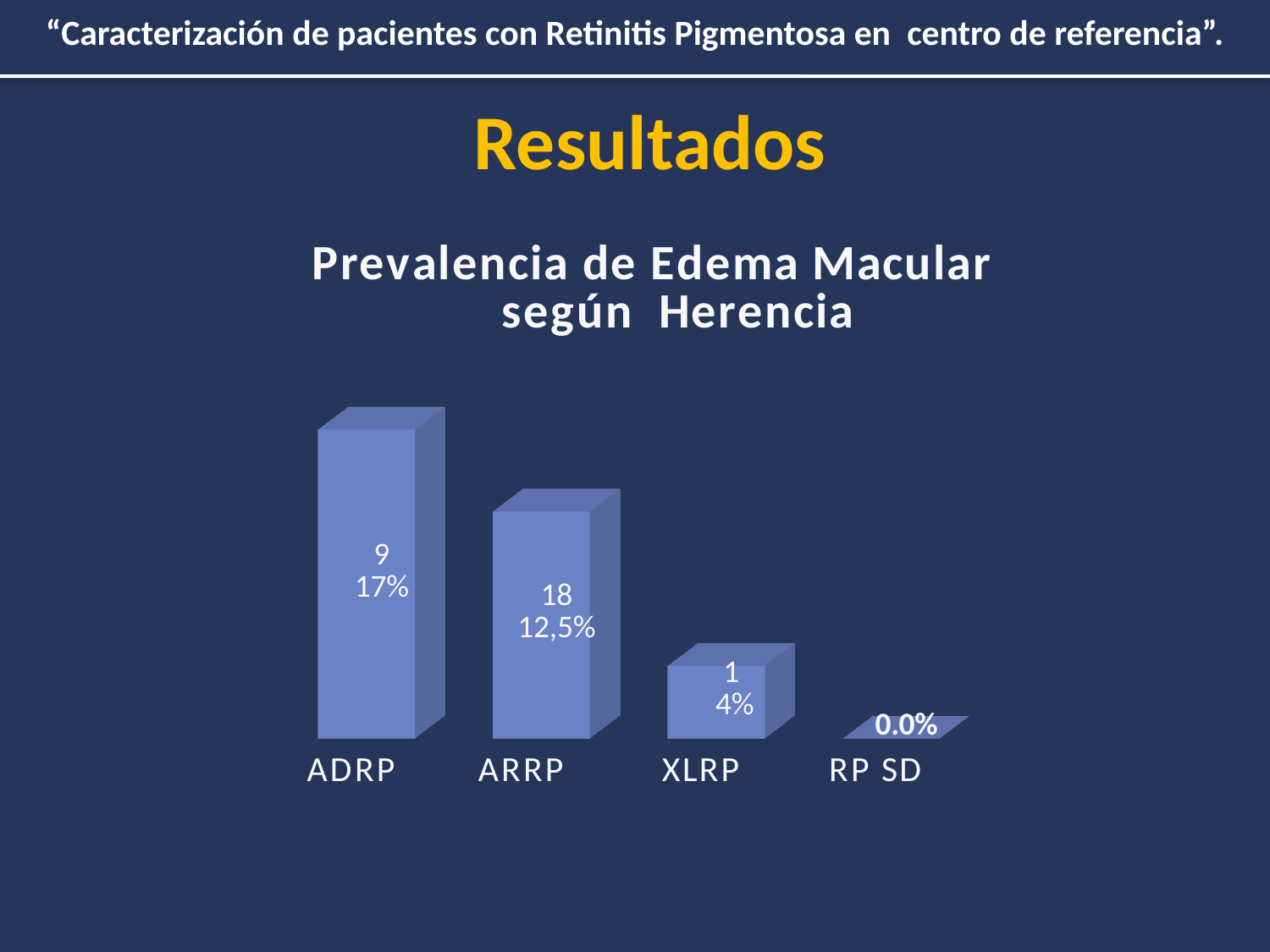
How many categories are shown on the x axis? 4 Do the bar heights rise or fall from left to right across the categories? Fall Which has the higher percentage, ARRP or XLRP? ARRP What percentage is shown on the bar for ARRP? 12,5% Which category has the tallest bar? ADRP What kind of chart is shown on the slide? Bar chart What number is printed above the percentage on the ARRP bar? 18 Which category has the lowest value? RP SD What is the difference in percentage points between ADRP (17%) and XLRP (4%)? 13 What value is shown for RP SD? 0.0% What percentage is shown on the bar for ADRP? 17% What percentage is shown on the bar for XLRP? 4%